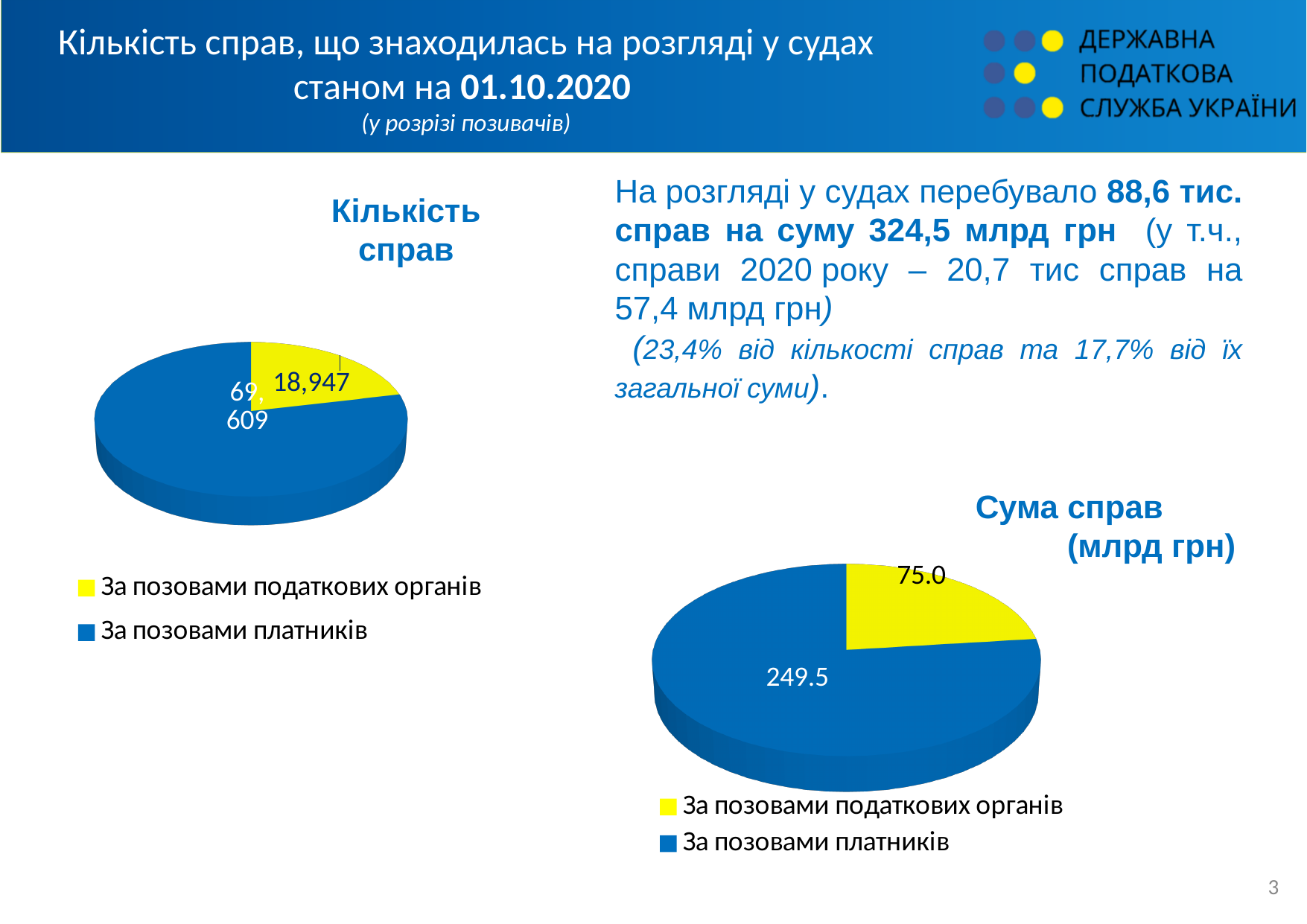
How many categories does the legend of the 'Сума справ (млрд грн)' chart list? 2 What kind of chart is the 'Кількість справ' chart? Pie chart In the 'Сума справ (млрд грн)' chart, which category has the smallest slice? За позовами податкових органів In the 'Сума справ (млрд грн)' chart, what is the total of the two slices? 324.5 In the 'Сума справ (млрд грн)' chart, what is the value for 'За позовами податкових органів'? 75.0 In the 'Кількість справ' chart, what colour is the slice for 'За позовами податкових органів'? Yellow In the 'Кількість справ' chart, which category has the largest slice? За позовами платників In the 'Сума справ (млрд грн)' chart, what is the value for 'За позовами платників'? 249.5 In the 'Кількість справ' chart, what is the value for 'За позовами платників'? 69,609 In the 'Кількість справ' chart, what is the difference between 'За позовами платників' and 'За позовами податкових органів'? 50,662 In the 'Кількість справ' chart, what is the value for 'За позовами податкових органів'? 18,947 In the 'Сума справ (млрд грн)' chart, what is the difference between 'За позовами платників' and 'За позовами податкових органів'? 174.5